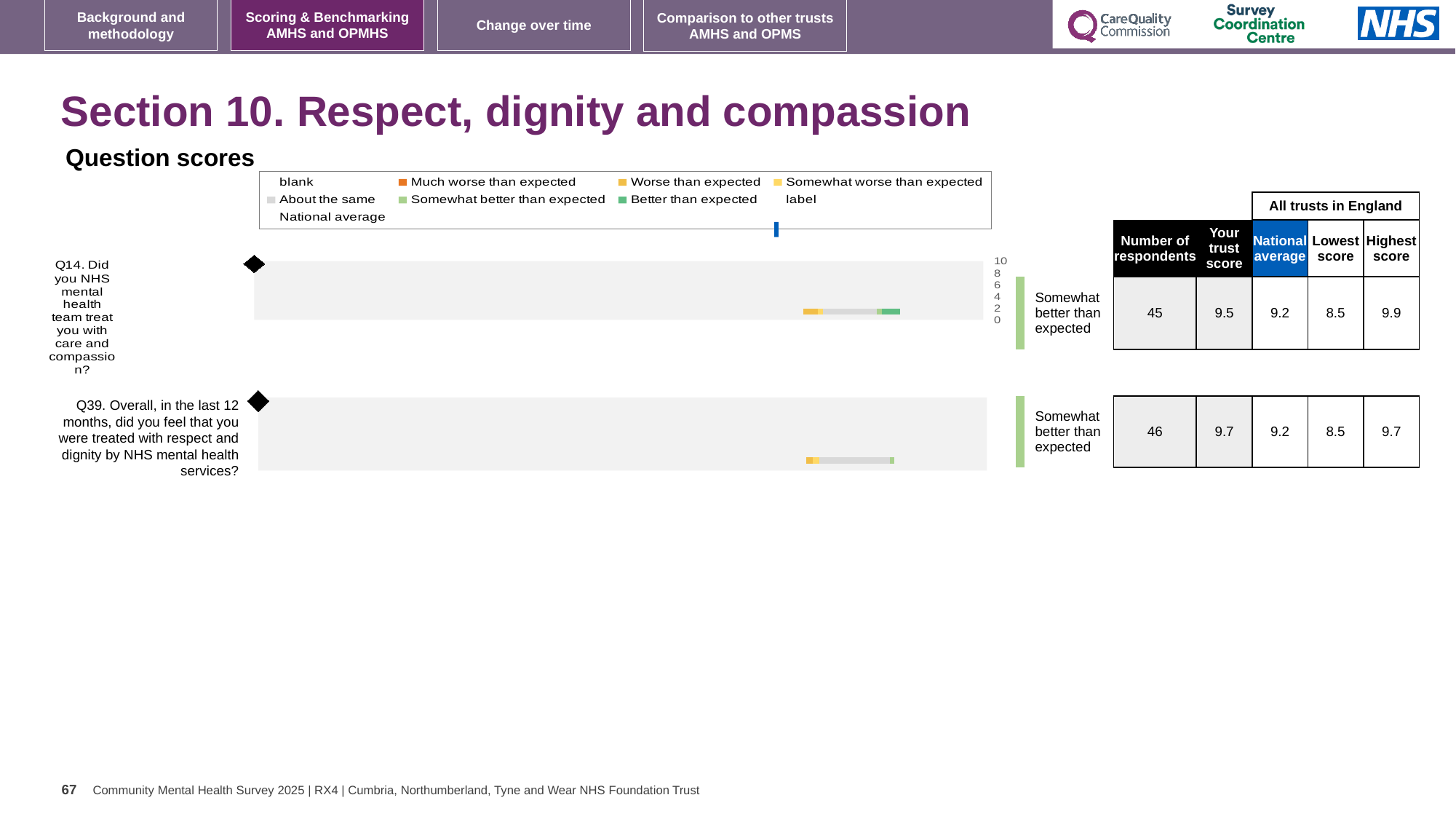
In the table beside the Q39 chart, what is the trust score for Q39? 9.7 In the table beside the Q39 chart, what is the highest score among all trusts in England for Q39? 9.7 In the table beside the Q14 chart, what is the national average for Q14? 9.2 What is the highest tick value shown on the axis of the question scores charts? 10 In the table beside the Q14 chart, how many respondents answered Q14? 45 What kind of chart is used for the Q14 and Q39 question scores? bar chart What benchmark category label is shown next to the Q39 chart? Somewhat better than expected What is the difference between the highest score and the lowest score for Q14 across all trusts in England? 1.4 Which question has the higher trust score, Q14 or Q39? Q39 What is the difference between the trust score and the national average for Q14? 0.3 How many questions are plotted in the question scores charts on this slide? 2 In the table beside the Q14 chart, what is the trust score for Q14? 9.5